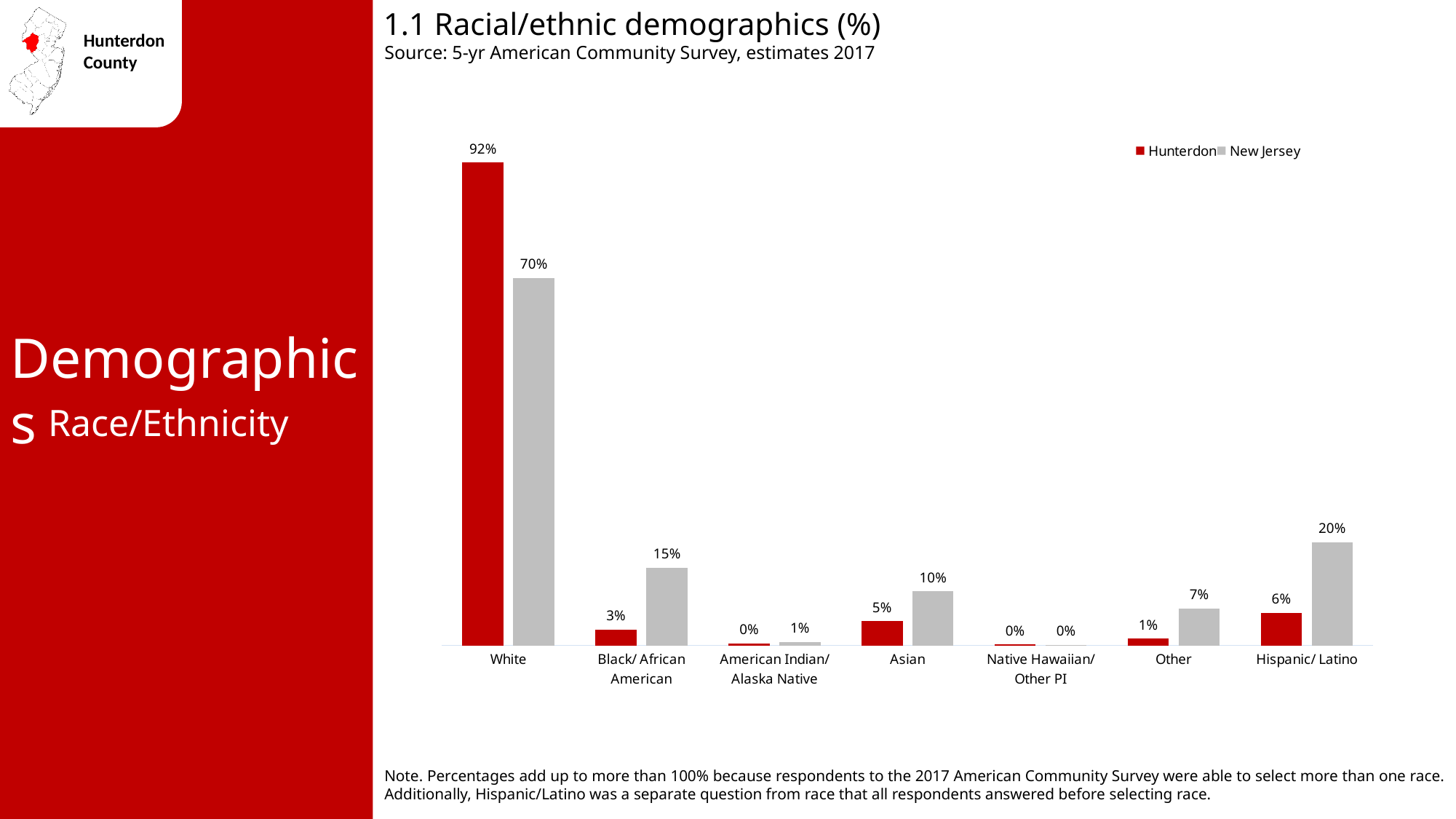
What kind of chart is shown? Bar chart Which series is shown in red? Hunterdon How many series does the legend list? 2 Which is larger for Asian, the Hunterdon value or the New Jersey value? New Jersey Which category has the highest Hunterdon value? White How many categories are shown on the x axis? 7 What is the New Jersey value for Black/ African American? 15% What is the Hunterdon value for White? 92% What is the difference between the New Jersey and Hunterdon values for Hispanic/ Latino? 14% What is the Hunterdon value for Asian? 5% What is the New Jersey value for Hispanic/ Latino? 20% What is the difference between the Hunterdon and New Jersey values for White? 22%